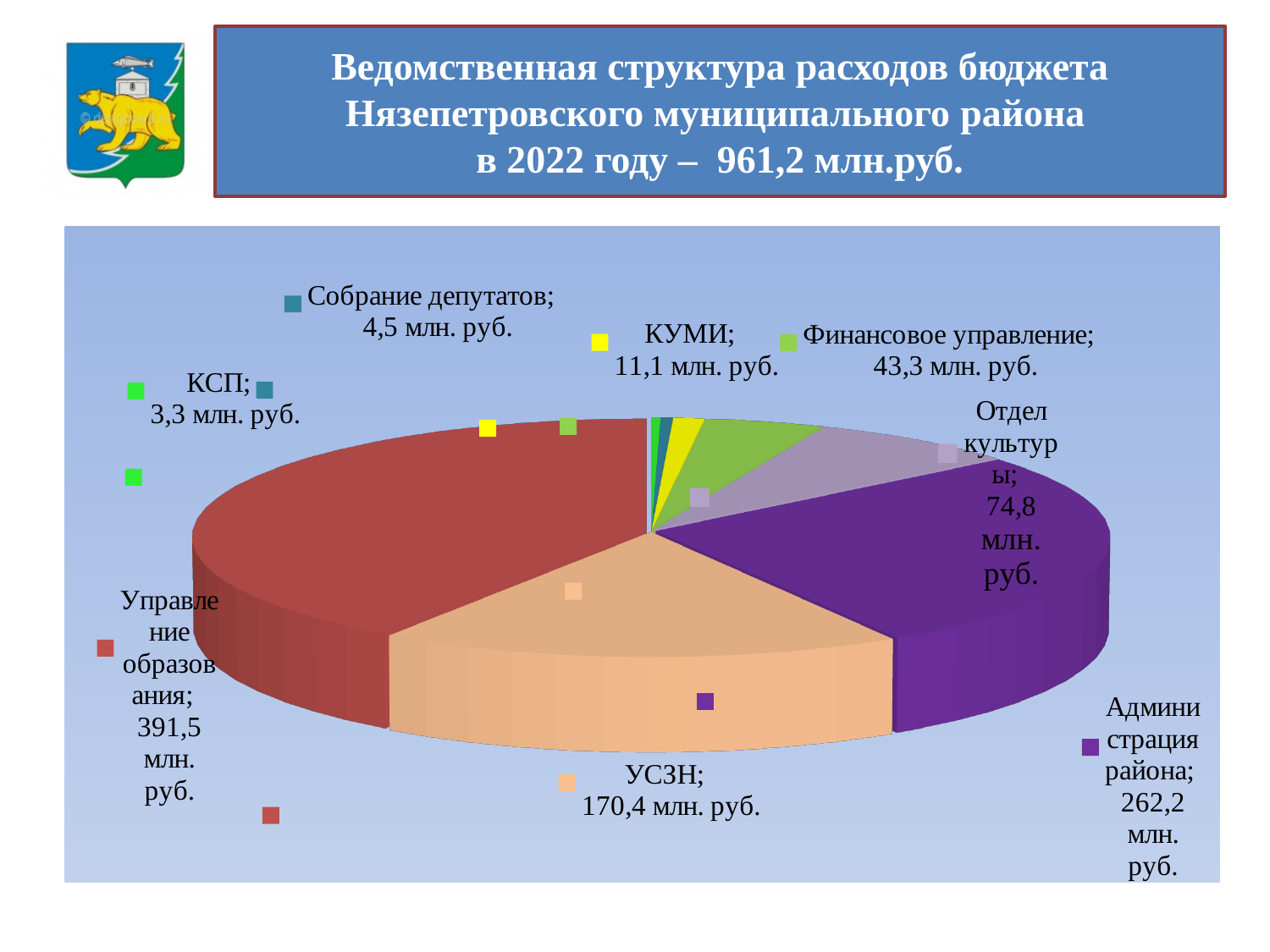
Which is larger, КУМИ or Собрание депутатов? КУМИ What is the value for КСП? 3,3 млн. руб. What is the value for УСЗН? 170,4 млн. руб. What is the difference between Отдел культуры and Финансовое управление? 31,5 млн. руб. What is the value for Администрация района? 262,2 млн. руб. What is the value for Финансовое управление? 43,3 млн. руб. Which category has the smallest value? КСП What is the difference between Управление образования and Администрация района? 129,3 млн. руб. What is the value for Управление образования? 391,5 млн. руб. How many categories are shown in the pie chart? 8 Which category has the largest share of the pie? Управление образования What kind of chart is shown on the slide? Pie chart